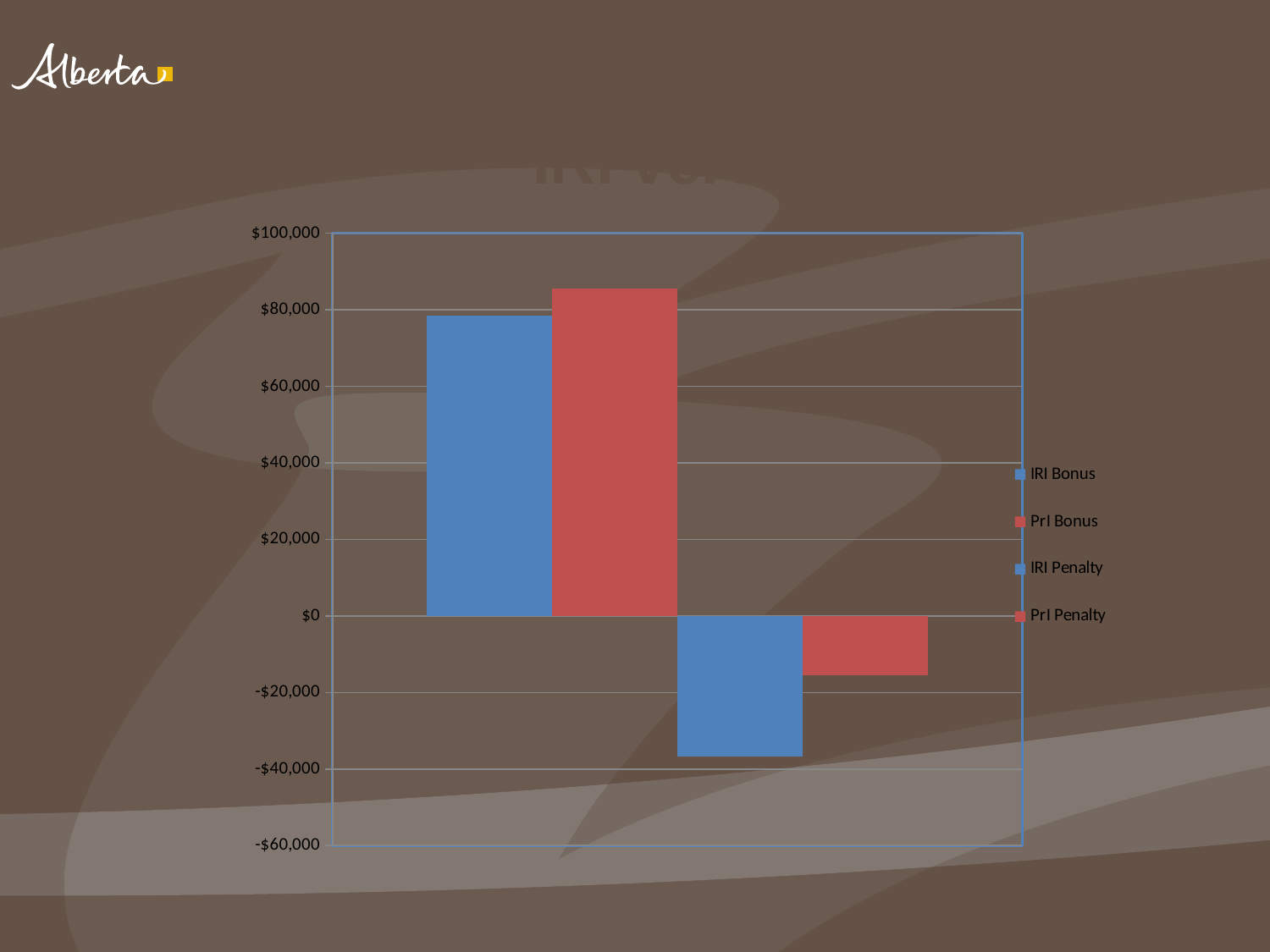
Which is larger, IRI Bonus or PrI Bonus? PrI Bonus What colour are the PrI Bonus and PrI Penalty bars? red Is the value for IRI Bonus greater or less than $60,000? greater Is the value for PrI Penalty greater or less than -$20,000? greater Is the value for PrI Bonus greater or less than $80,000? greater What kind of chart is shown on the slide? bar chart Which is larger, IRI Penalty or PrI Penalty? PrI Penalty Which series has the highest value? PrI Bonus How many bars are plotted in the chart? 4 How many series does the legend list? 4 Which series has the lowest value? IRI Penalty